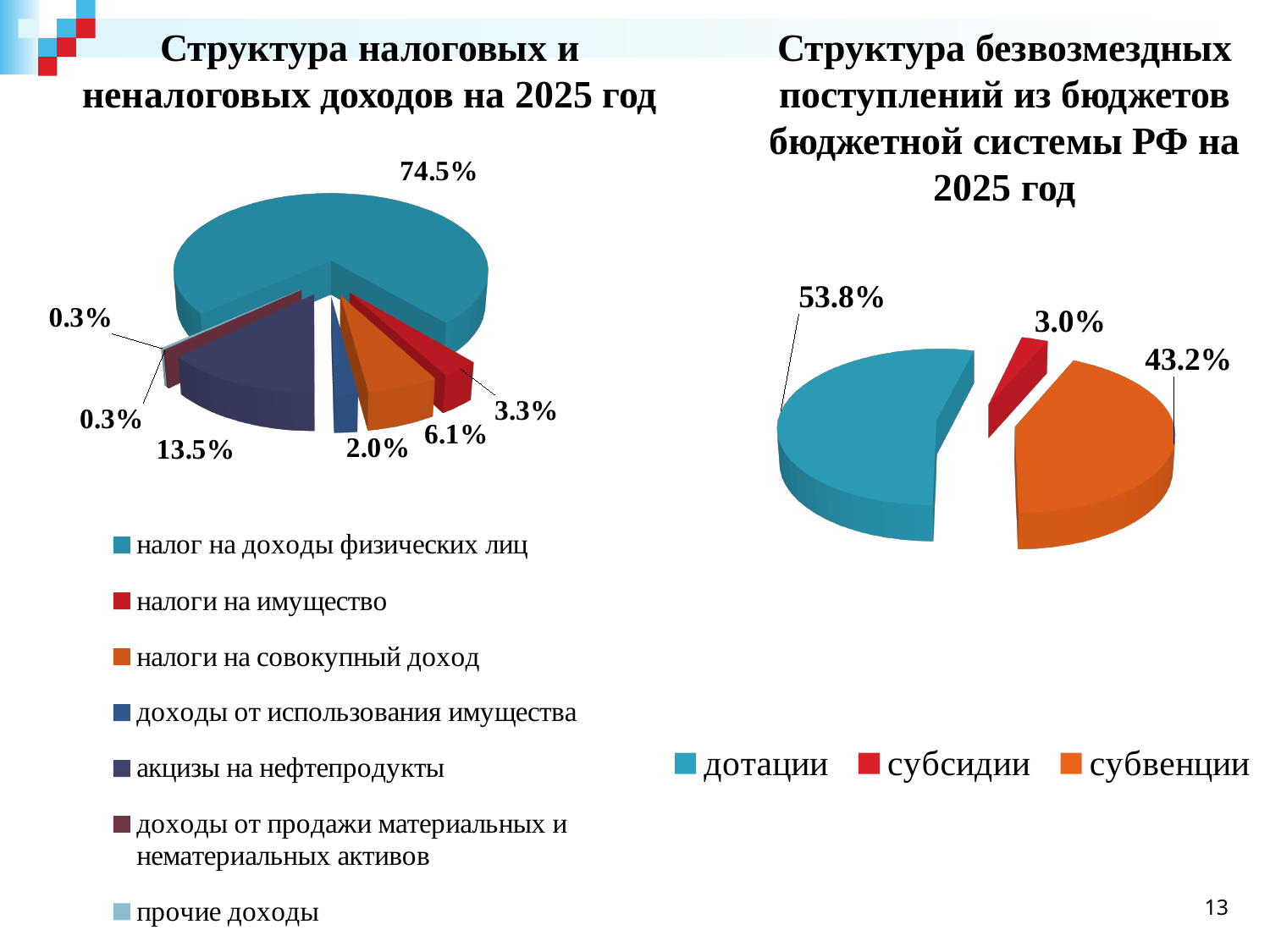
In the chart titled "Структура безвозмездных поступлений из бюджетов бюджетной системы РФ на 2025 год", which category has the smallest share? субсидии In the chart titled "Структура безвозмездных поступлений из бюджетов бюджетной системы РФ на 2025 год", what share do дотации have? 53.8% In the chart titled "Структура налоговых и неналоговых доходов на 2025 год", what share does налог на доходы физических лиц have? 74.5% In the chart titled "Структура налоговых и неналоговых доходов на 2025 год", what share do налоги на совокупный доход have? 6.1% In the chart titled "Структура безвозмездных поступлений из бюджетов бюджетной системы РФ на 2025 год", what is the difference between the shares of дотации and субвенции? 10.6% In the chart titled "Структура безвозмездных поступлений из бюджетов бюджетной системы РФ на 2025 год", what share do субвенции have? 43.2% In the chart titled "Структура безвозмездных поступлений из бюджетов бюджетной системы РФ на 2025 год", how many categories does the legend list? 3 What type of chart is the chart titled "Структура налоговых и неналоговых доходов на 2025 год"? pie chart In the chart titled "Структура налоговых и неналоговых доходов на 2025 год", which category has the largest share? налог на доходы физических лиц In the chart titled "Структура налоговых и неналоговых доходов на 2025 год", which is larger: налоги на имущество or налоги на совокупный доход? налоги на совокупный доход In the chart titled "Структура налоговых и неналоговых доходов на 2025 год", what share do акцизы на нефтепродукты have? 13.5% In the chart titled "Структура налоговых и неналоговых доходов на 2025 год", how many categories does the legend list? 7